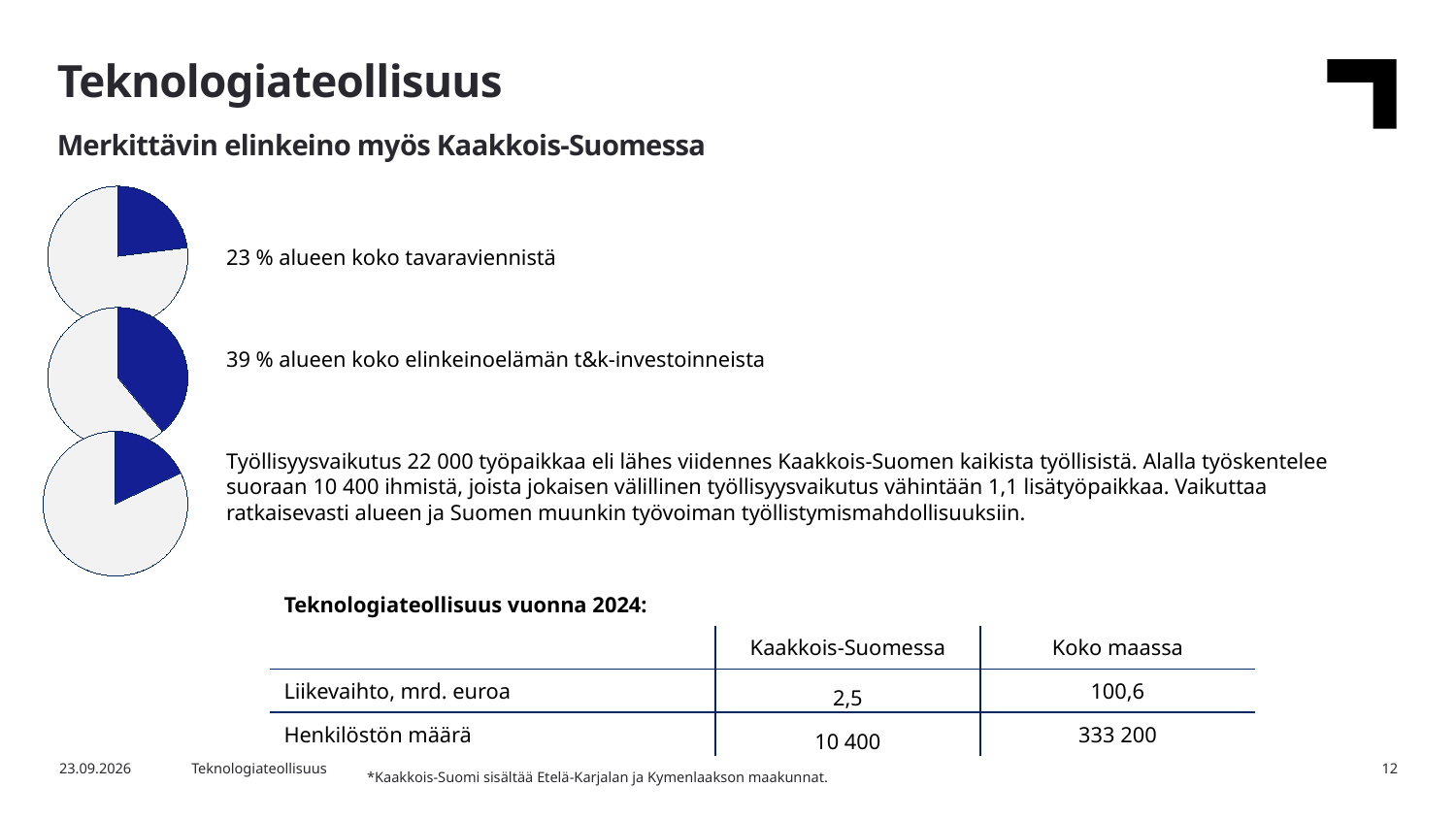
Which of the three pie charts has the largest blue slice? The middle pie chart In the top pie chart, what share of the region's total goods exports does the blue slice represent? 23 % What does the top pie chart illustrate, according to the text next to it? 23 % alueen koko tavaraviennistä What colour is the highlighted slice in each pie chart? Blue How many pie charts are shown on the slide? 3 Is the blue slice in the middle pie chart greater or less than 25% of the pie? greater How many slices does each pie chart have? 2 Is the blue slice in the middle pie chart larger or smaller than the blue slice in the top pie chart? Larger In the middle pie chart, what share of the region's business R&D investments does the blue slice represent? 39 % Is the blue slice in the top pie chart greater or less than 50% of the pie? less What kind of chart is used on the left side of the slide? Pie chart